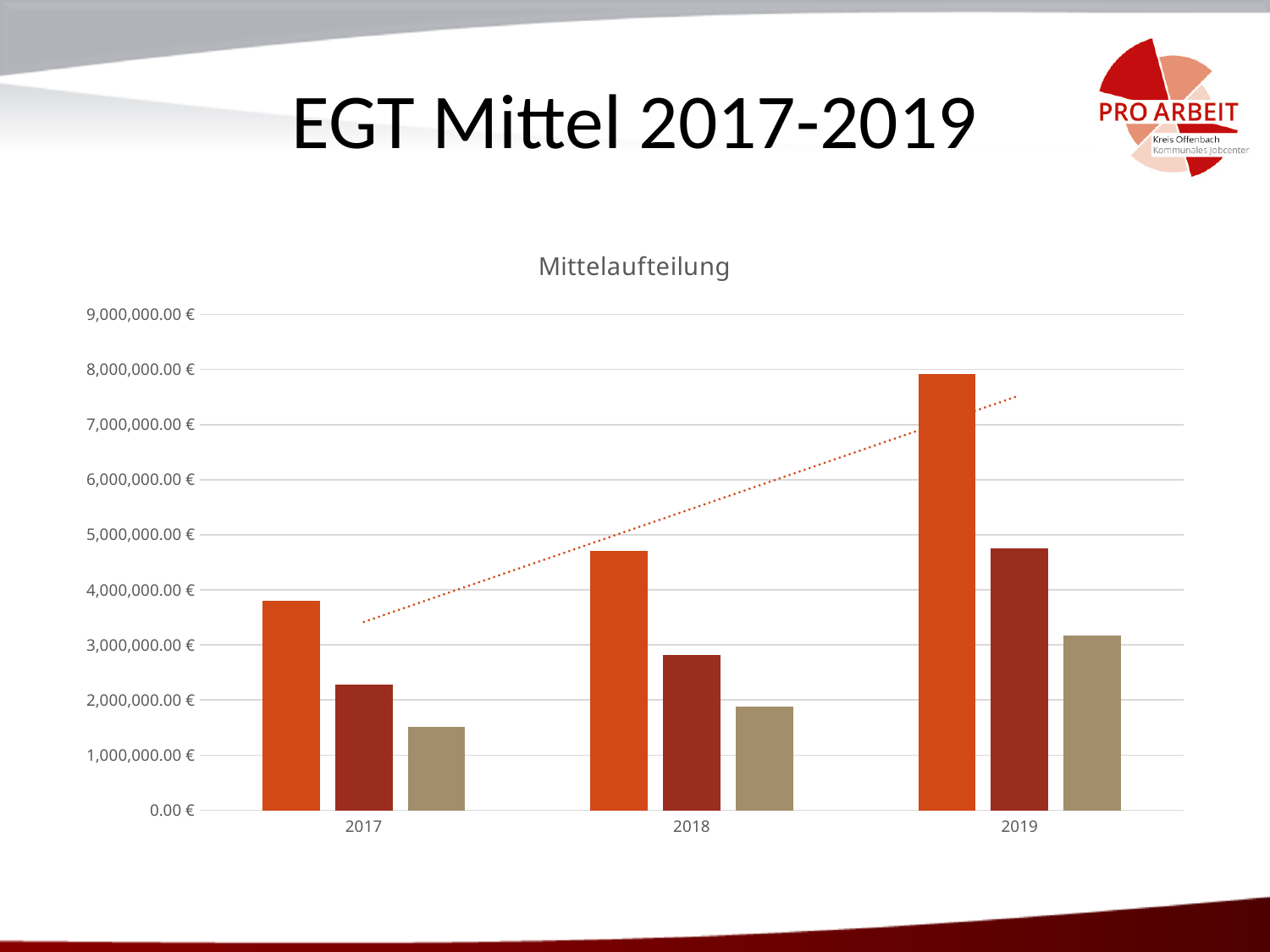
Is the value of the orange bar for 2018 greater or less than 4,000,000.00 €? greater In which year is the tan bar the shortest? 2017 Is the value of the dark red bar for 2019 greater or less than 4,000,000.00 €? greater In which year is the orange bar the tallest? 2019 What type of chart is shown on the slide? bar chart What is the title of the chart? Mittelaufteilung Is the value of the tan bar for 2017 greater or less than 2,000,000.00 €? less Which is larger: the dark red bar for 2017 or the dark red bar for 2018? 2018 How many years are shown on the x axis of the chart? 3 How many bars are plotted for each year in the chart? 3 Do the orange bars rise or fall from 2017 to 2019? rise